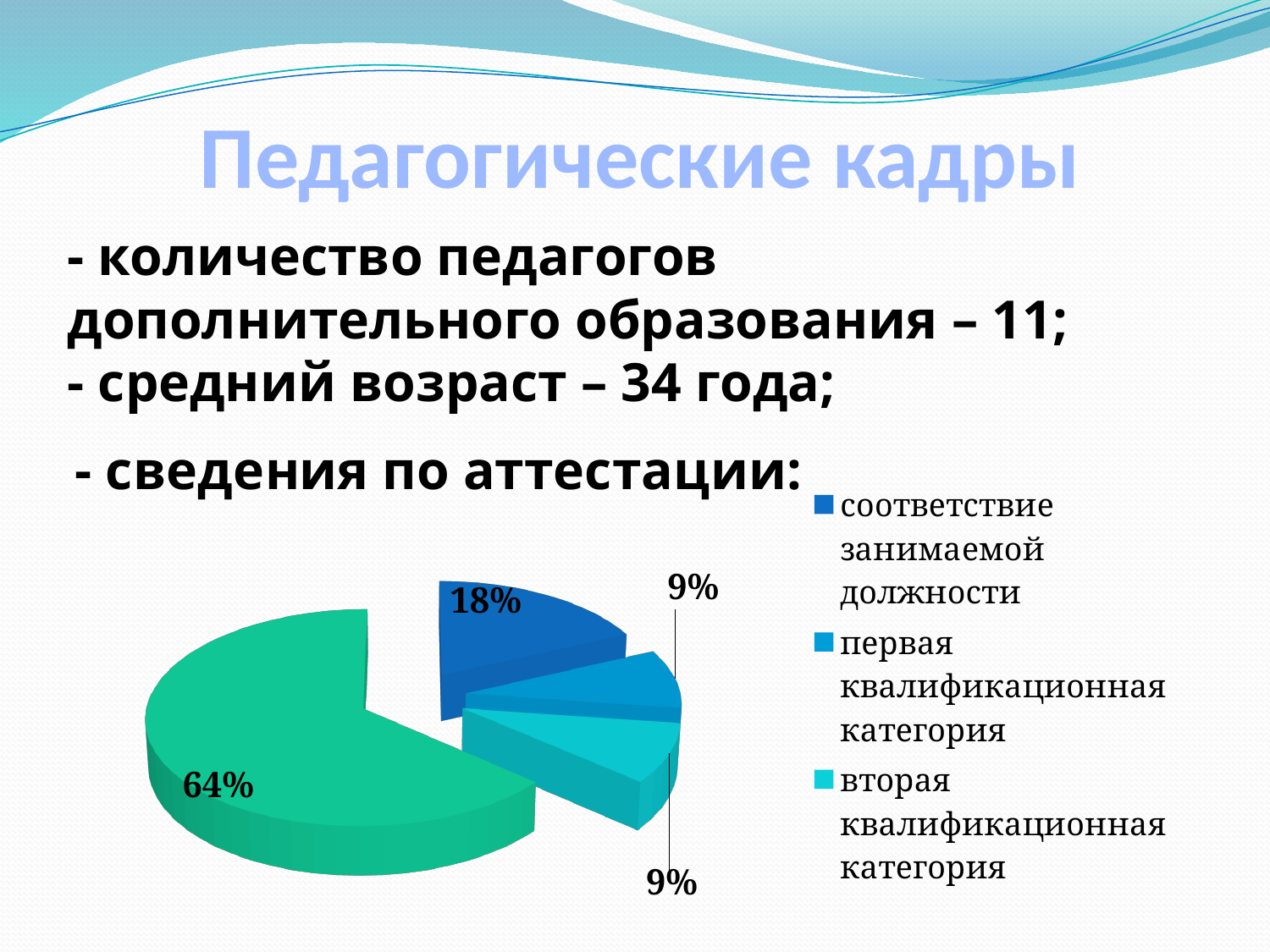
How many slices does the pie chart have? 4 What is the sum of all the percentage labels on the pie chart? 100% Which is larger: the slice for 'соответствие занимаемой должности' or the slice for 'первая квалификационная категория'? соответствие занимаемой должности What is the largest percentage value labelled on the pie chart? 64% How many entries does the legend of the pie chart list? 3 By how many percentage points does the largest slice (64%) exceed the 'соответствие занимаемой должности' slice? 46 percentage points What colour is the slice for 'соответствие занимаемой должности'? dark blue What is the smallest percentage value labelled on the pie chart? 9% What percentage is shown for 'соответствие занимаемой должности'? 18% What percentage is shown for 'первая квалификационная категория'? 9% What percentage is shown for 'вторая квалификационная категория'? 9% What kind of chart is shown on the slide? pie chart